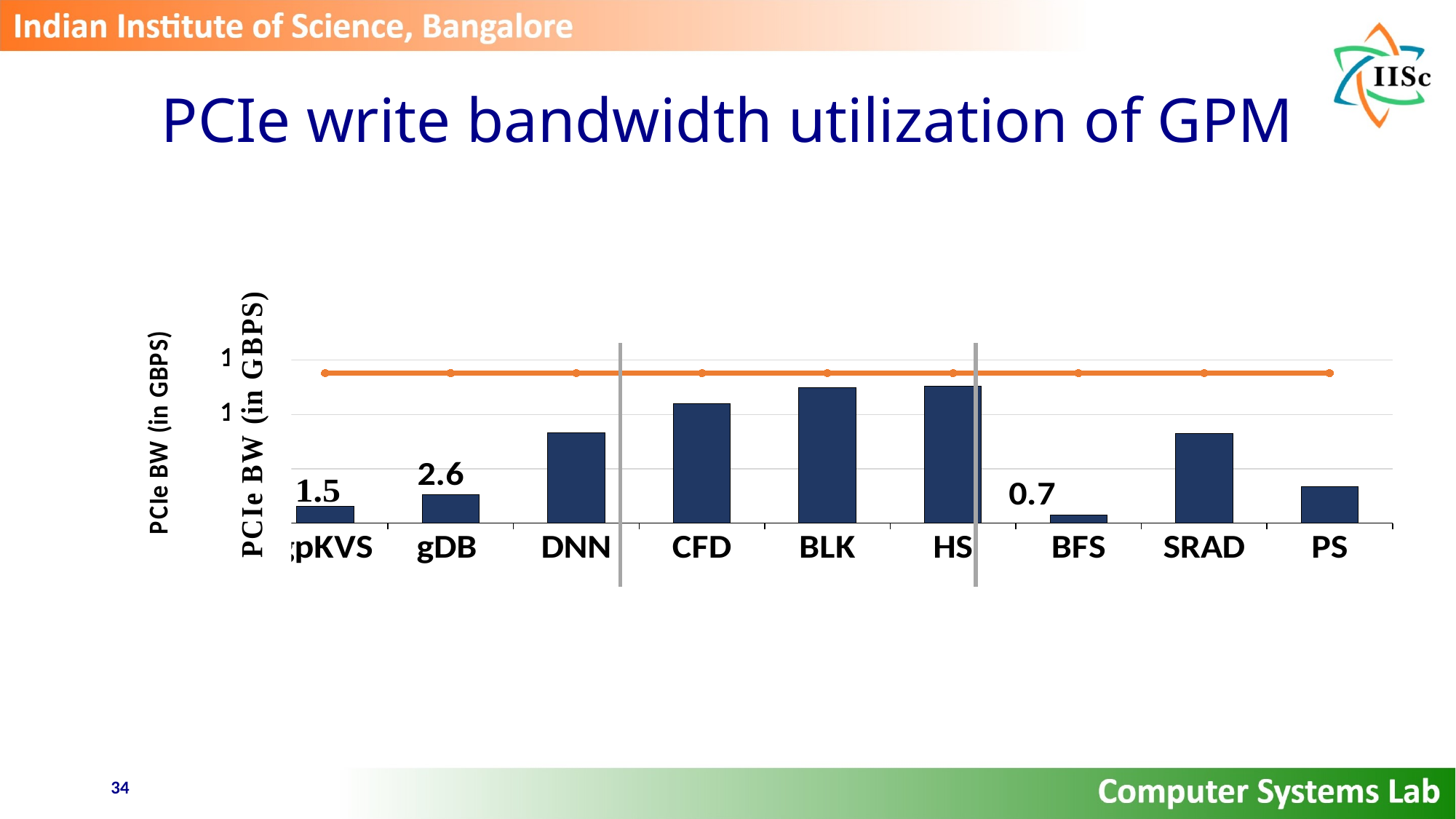
What is the difference between the labelled values for gDB and BFS? 1.9 Which has the taller bar, gDB or BFS? gDB What is the label on the y axis of the chart? PCIe BW (in GBPS) Does any bar rise above the orange horizontal line? No Which has the taller bar, CFD or DNN? CFD Which benchmark has the lowest PCIe write bandwidth bar? BFS What is the PCIe write bandwidth value shown for gDB? 2.6 What kind of chart is shown on the slide? Bar chart How many benchmarks (bars) are shown on the x axis? 9 Which has the taller bar, BLK or DNN? BLK What is the PCIe write bandwidth value shown for BFS? 0.7